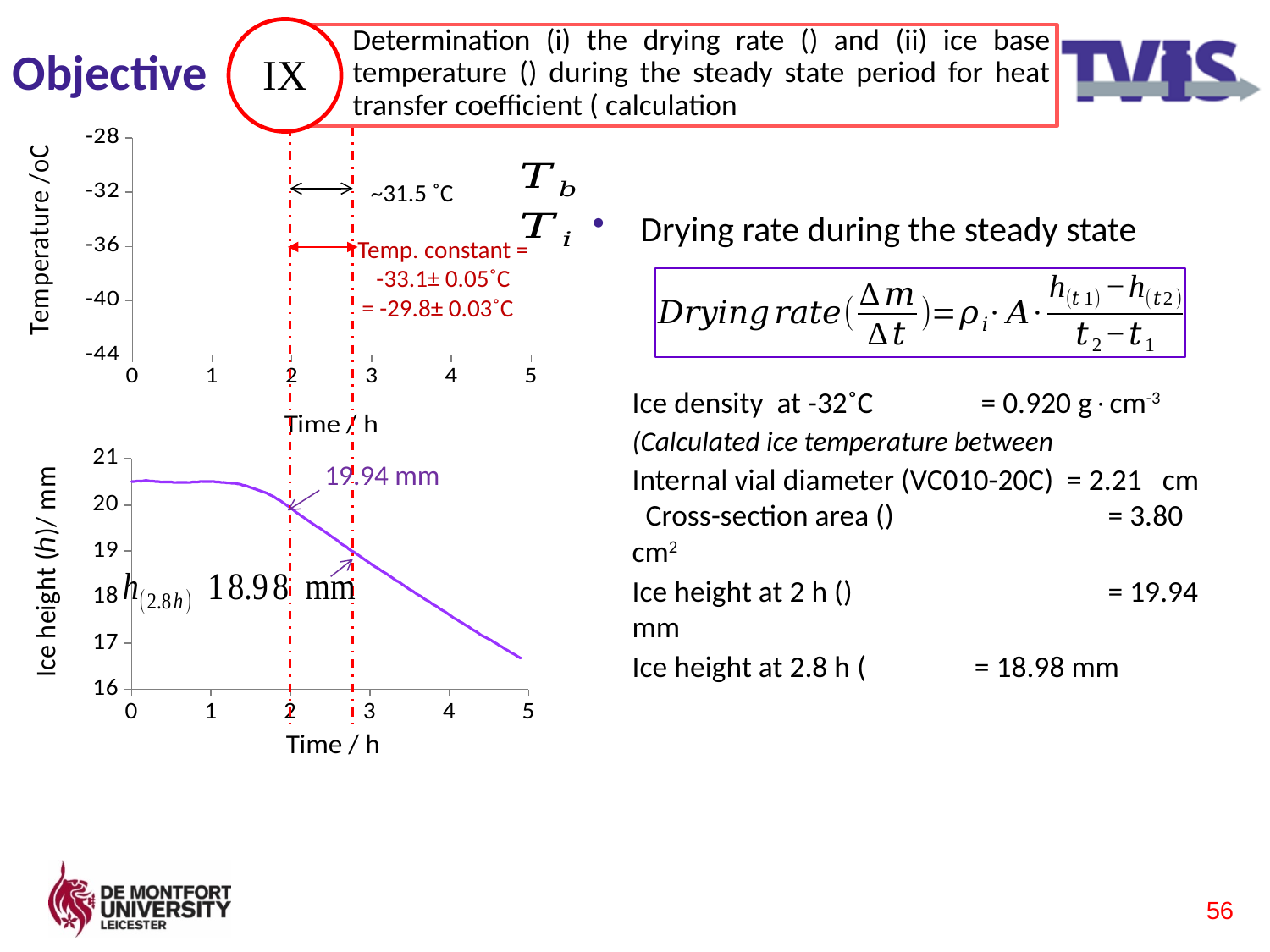
In the bottom chart (Ice height vs Time), does the ice height rise or fall as time increases from 2 h to 5 h? fall What is the y-axis label of the top chart? Temperature /oC In the bottom chart (Ice height vs Time), what is the ice height at 2 h? 19.94 mm In the bottom chart (Ice height vs Time), is the ice height at 3 h greater or less than 19? less What is the x-axis label of the bottom chart? Time / h In the bottom chart (Ice height vs Time), is the ice height at 4 h greater or less than 18? less In the bottom chart (Ice height vs Time), which is larger: the ice height at 2 h or at 2.8 h? 2 h In the bottom chart (Ice height vs Time), what is the difference between the ice height at 2 h and at 2.8 h? 0.96 mm In the bottom chart (Ice height vs Time), is the ice height at 1 h greater or less than 20? greater In the bottom chart (Ice height vs Time), what is the ice height at 2.8 h? 18.98 mm What kind of chart is the bottom chart (Ice height vs Time)? line chart